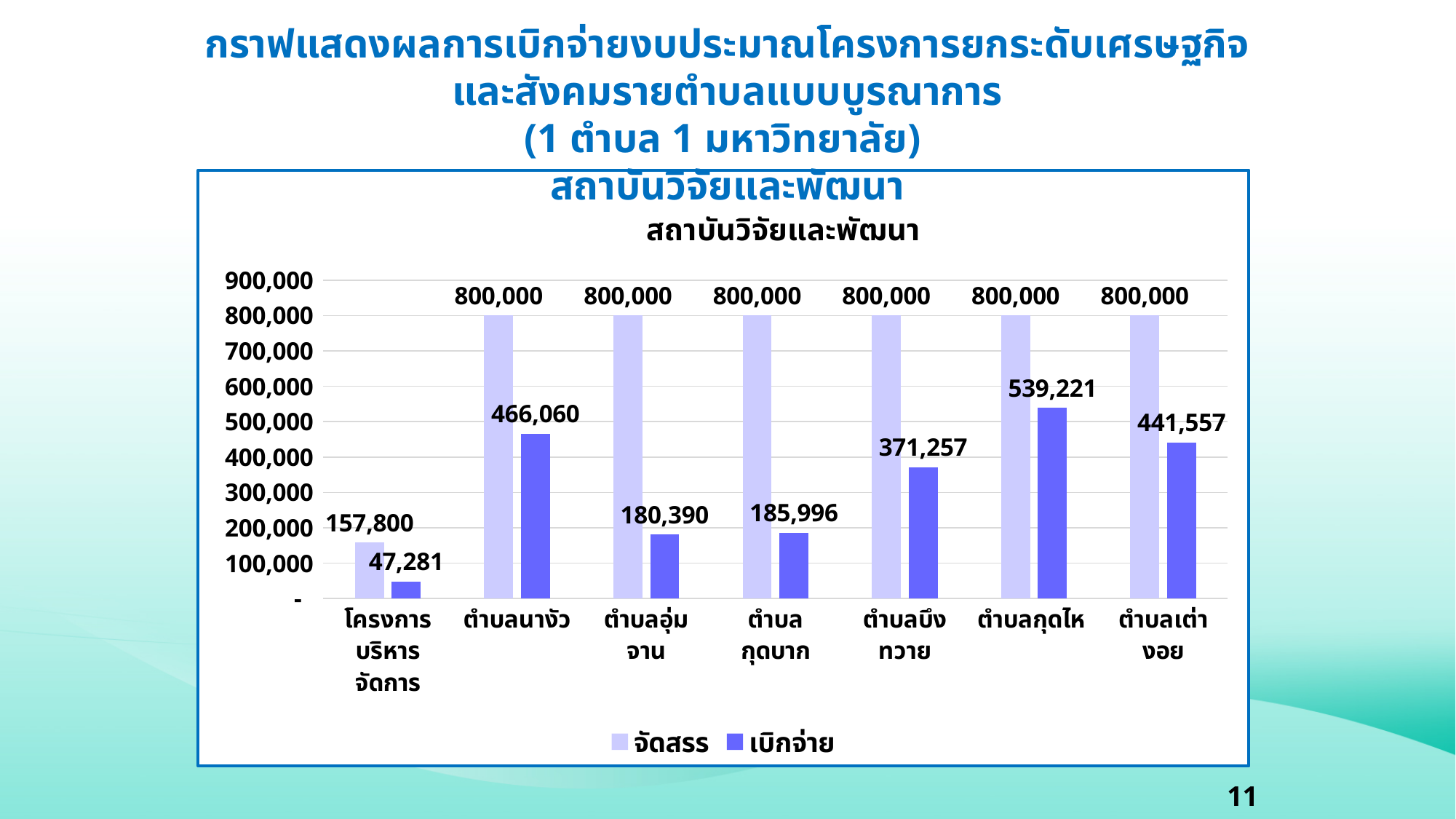
Which category has the lowest เบิกจ่าย value? โครงการบริหารจัดการ What is the จัดสรร value for โครงการบริหารจัดการ? 157,800 What is the difference between the จัดสรร and เบิกจ่าย values for ตำบลเต่างอย? 358,443 How many categories are shown on the x axis? 7 What is the title of the chart? สถาบันวิจัยและพัฒนา Is the เบิกจ่าย value for ตำบลกุดบาก greater or less than 200,000? less Which is larger, the เบิกจ่าย value for ตำบลบึงทวาย or for ตำบลอุ่มจาน? ตำบลบึงทวาย What is the เบิกจ่าย value for ตำบลนางัว? 466,060 Which category has the highest เบิกจ่าย value? ตำบลกุดไห What is the เบิกจ่าย value for ตำบลกุดไห? 539,221 What kind of chart is shown? bar chart How many series does the legend list? 2